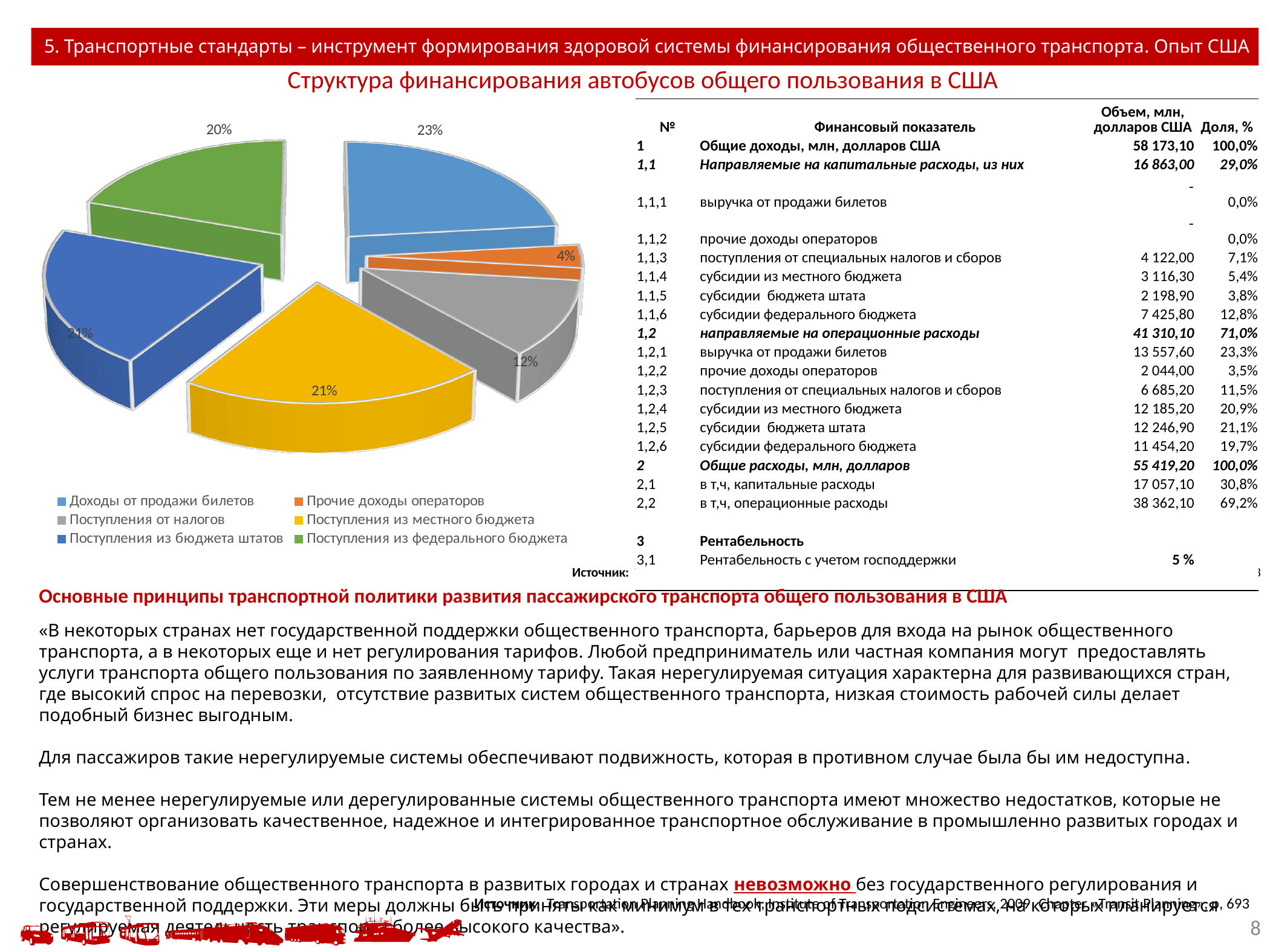
What share of the pie does "Доходы от продажи билетов" have? 23% What is the difference in percentage points between "Доходы от продажи билетов" and "Прочие доходы операторов"? 19 What is the value shown for "Поступления из федерального бюджета" in the pie chart? 20% Which is larger in the pie chart: "Доходы от продажи билетов" or "Поступления из федерального бюджета"? Доходы от продажи билетов What is the title of the pie chart? Структура финансирования автобусов общего пользования в США How many entries does the legend of the pie chart list? 6 What is the value shown for "Поступления от налогов" in the pie chart? 12% What kind of chart is shown on the slide? pie chart Which category has the smallest slice in the pie chart? Прочие доходы операторов Which category has the largest slice in the pie chart? Доходы от продажи билетов What is the value shown for "Прочие доходы операторов" in the pie chart? 4% How many slices does the pie chart have? 6